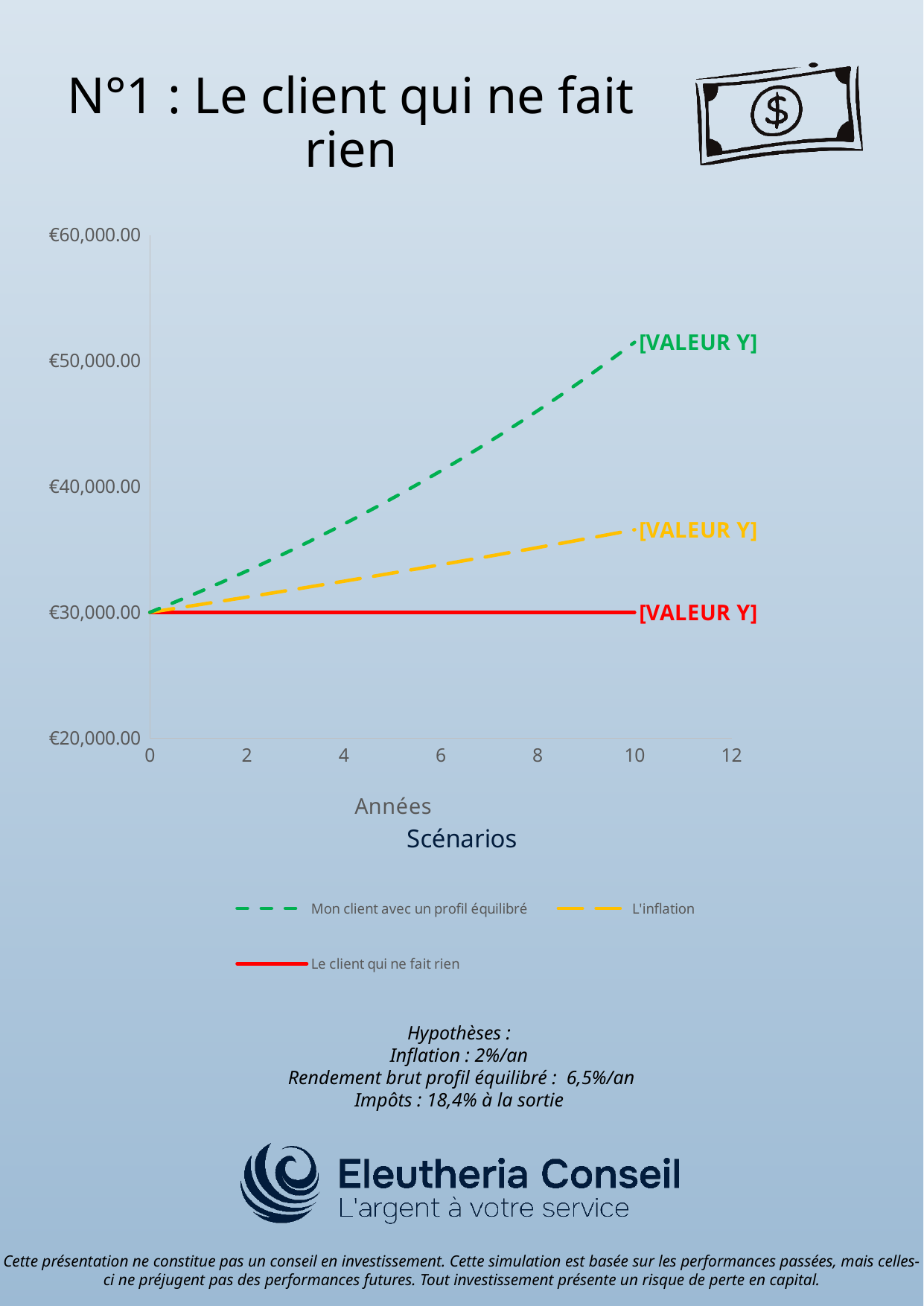
Which series has the highest value at year 10? Mon client avec un profil équilibré At year 0, what value do all three series start from? €30,000.00 What is the label of the x axis? Années Is the value for 'L'inflation' at year 10 greater or less than €40,000.00? less What kind of chart is shown on the slide? line chart Does the 'Mon client avec un profil équilibré' series rise or fall from year 0 to year 10? rise Which series has the lowest value at year 10? Le client qui ne fait rien At year 10, which is larger: 'L'inflation' or 'Le client qui ne fait rien'? L'inflation How many series does the chart legend list? 3 Is the value for 'Mon client avec un profil équilibré' at year 10 greater or less than €50,000.00? greater What is the value of the 'Le client qui ne fait rien' series at year 10? €30,000.00